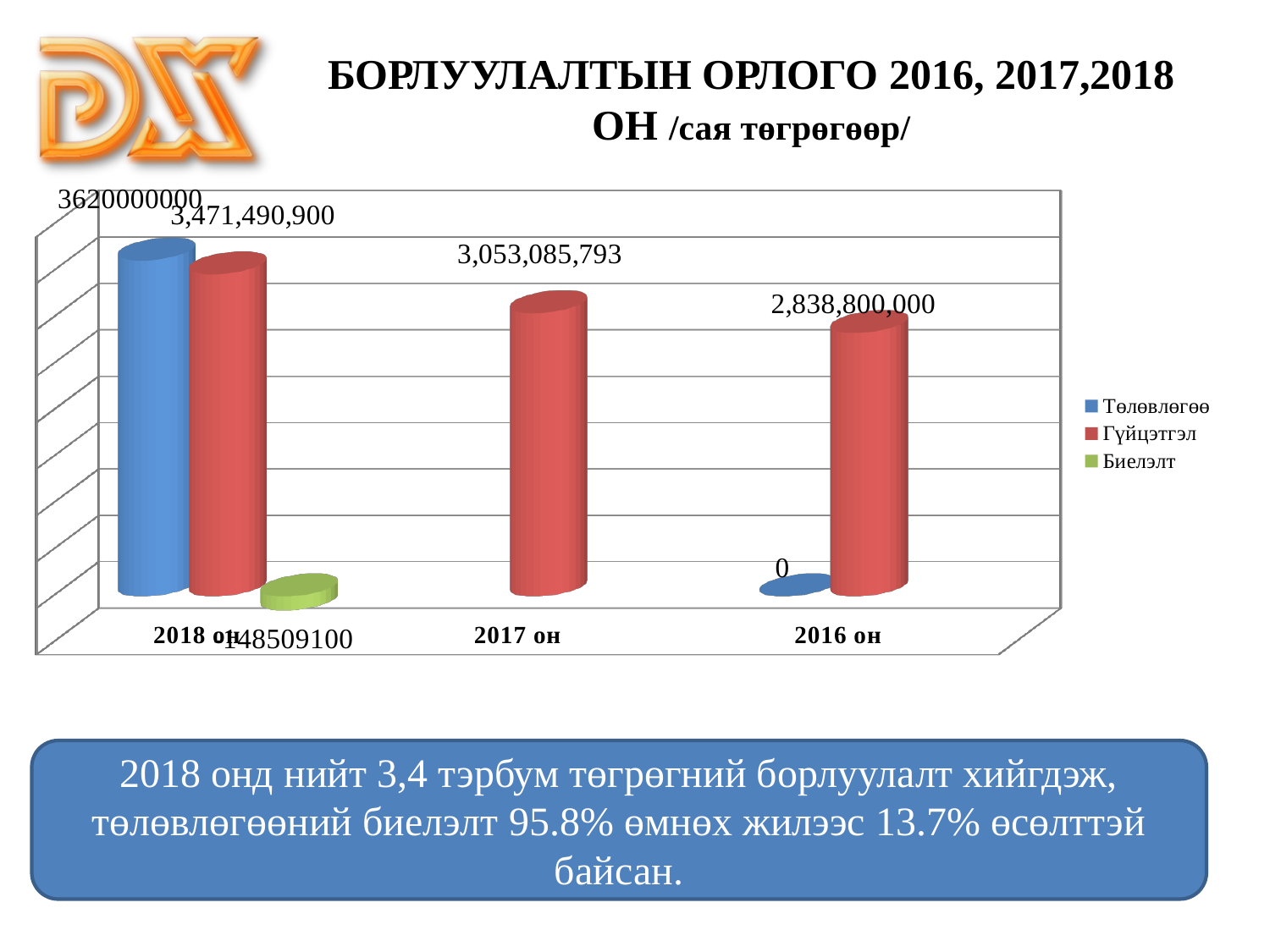
What kind of chart is shown on the slide? bar chart What is the difference between the Гүйцэтгэл values for 2018 он and 2017 он? 418,405,107 What is the value of Гүйцэтгэл for 2016 он? 2,838,800,000 What is the value of Гүйцэтгэл for 2017 он? 3,053,085,793 What is the value of Төлөвлөгөө for 2016 он? 0 What is the value of Төлөвлөгөө for 2018 он? 3620000000 How many series does the legend list? 3 Which year has the highest Гүйцэтгэл value? 2018 он What is the value of Гүйцэтгэл for 2018 он? 3,471,490,900 For 2018 он, which is larger: Төлөвлөгөө or Гүйцэтгэл? Төлөвлөгөө How many year categories are shown on the x axis? 3 Which year has the lowest Гүйцэтгэл value? 2016 он